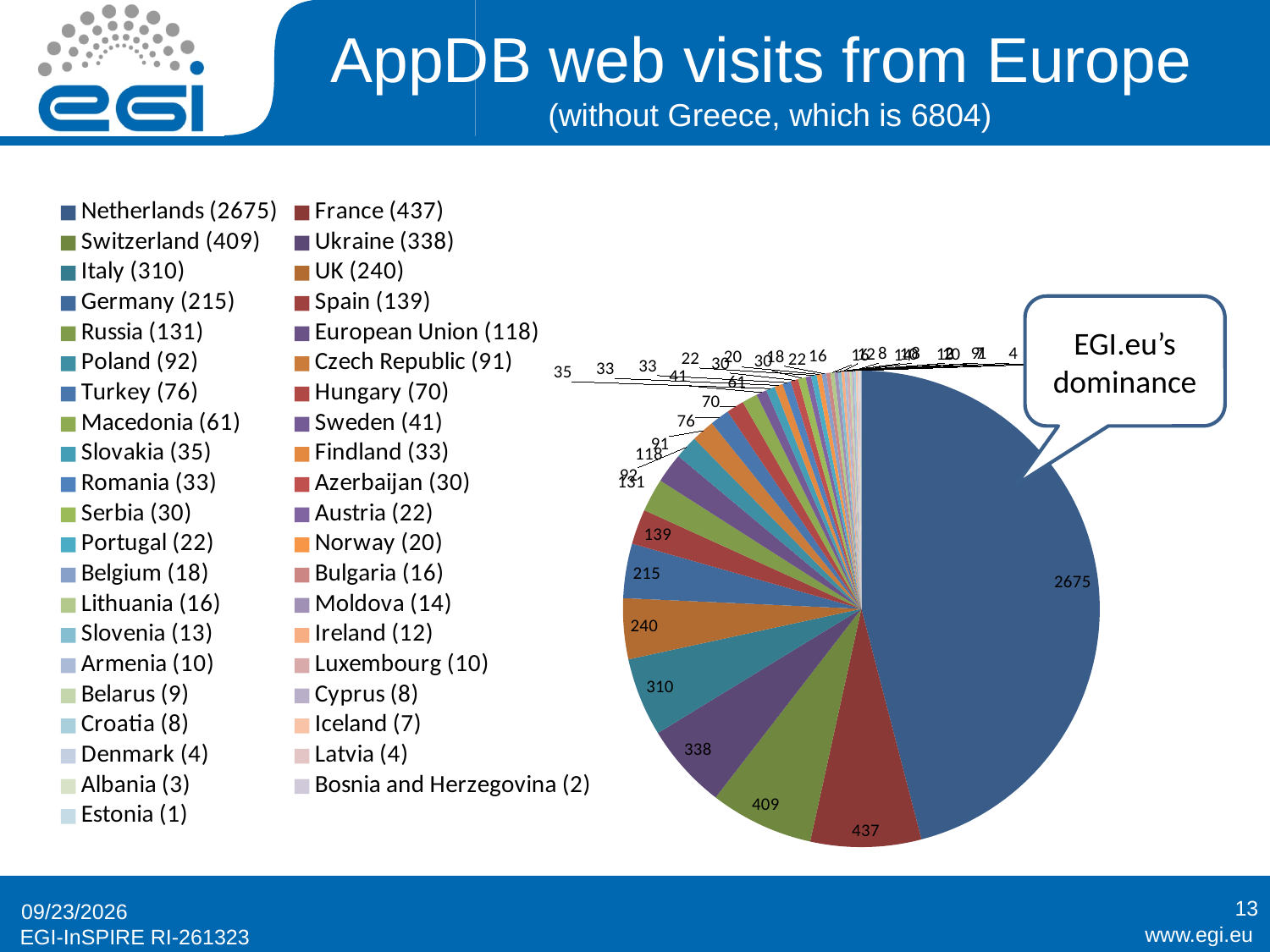
Which country has the smallest number of web visits in the legend? Estonia What does the callout next to the pie chart say? EGI.eu's dominance What kind of chart is shown on the slide? pie chart What is the difference in web visits between Switzerland and Ukraine? 71 How many web visits came from the Netherlands? 2675 How many web visits came from the Czech Republic? 91 How many web visits came from the UK? 240 How many web visits came from France? 437 What is the difference in web visits between the Netherlands and France? 2238 How many countries or regions are listed in the legend? 41 Which country has the largest slice of the pie? Netherlands Which has more web visits, Italy or Germany? Italy